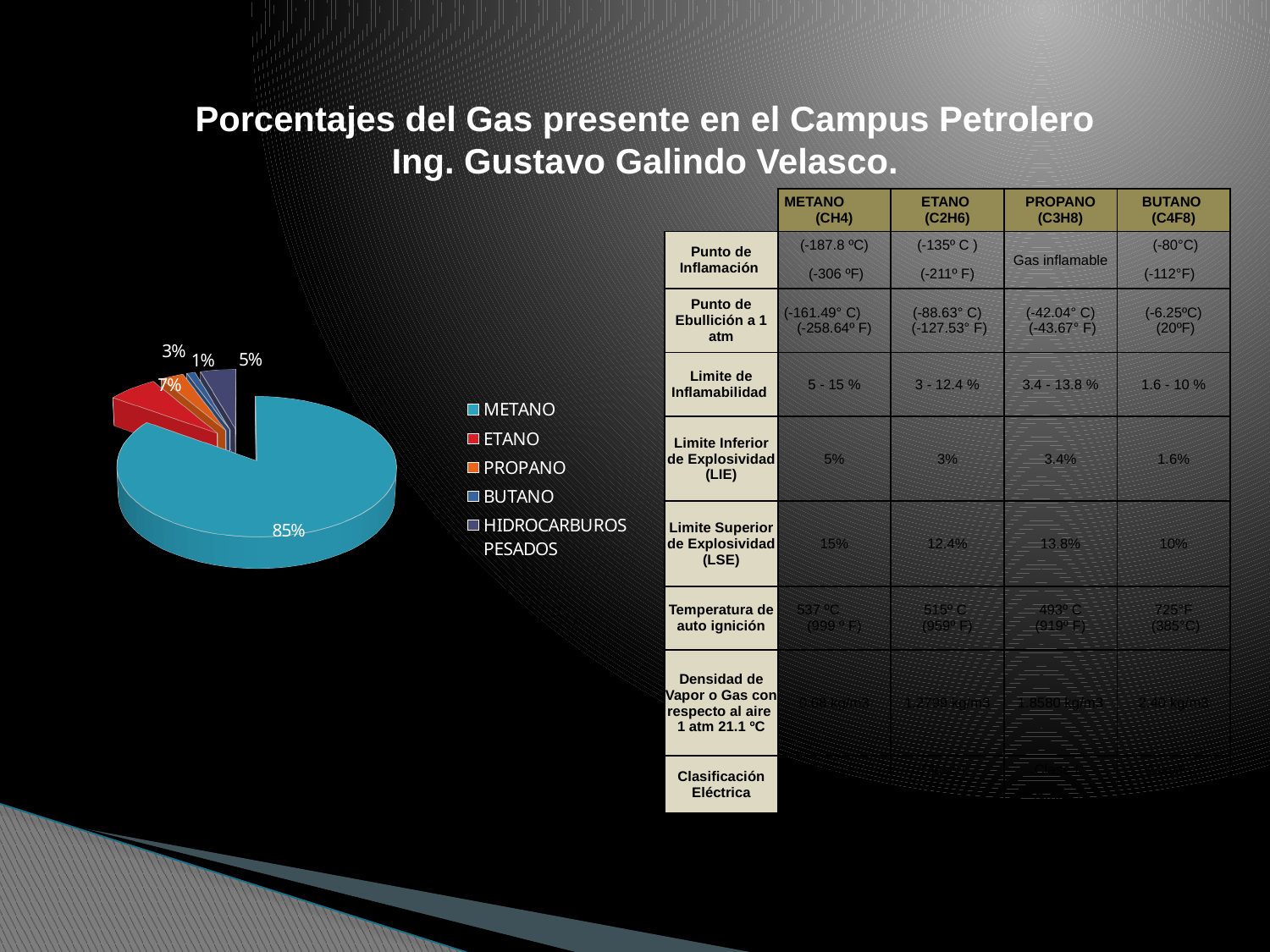
What percentage of the pie chart corresponds to METANO? 85% How many categories does the pie chart legend list? 5 What is the difference in percentage points between METANO and ETANO in the pie chart? 78 What type of chart is shown on the slide? Pie chart What percentage of the pie chart corresponds to BUTANO? 1% What percentage of the pie chart corresponds to ETANO? 7% Which category has the smallest share of the pie chart? BUTANO Which legend entry is shown in red in the pie chart? ETANO Which category has the largest share of the pie chart? METANO Which has a larger share in the pie chart, PROPANO or HIDROCARBUROS PESADOS? HIDROCARBUROS PESADOS What percentage of the pie chart corresponds to HIDROCARBUROS PESADOS? 5% What is the title of the slide containing the pie chart? Porcentajes del Gas presente en el Campus Petrolero Ing. Gustavo Galindo Velasco.